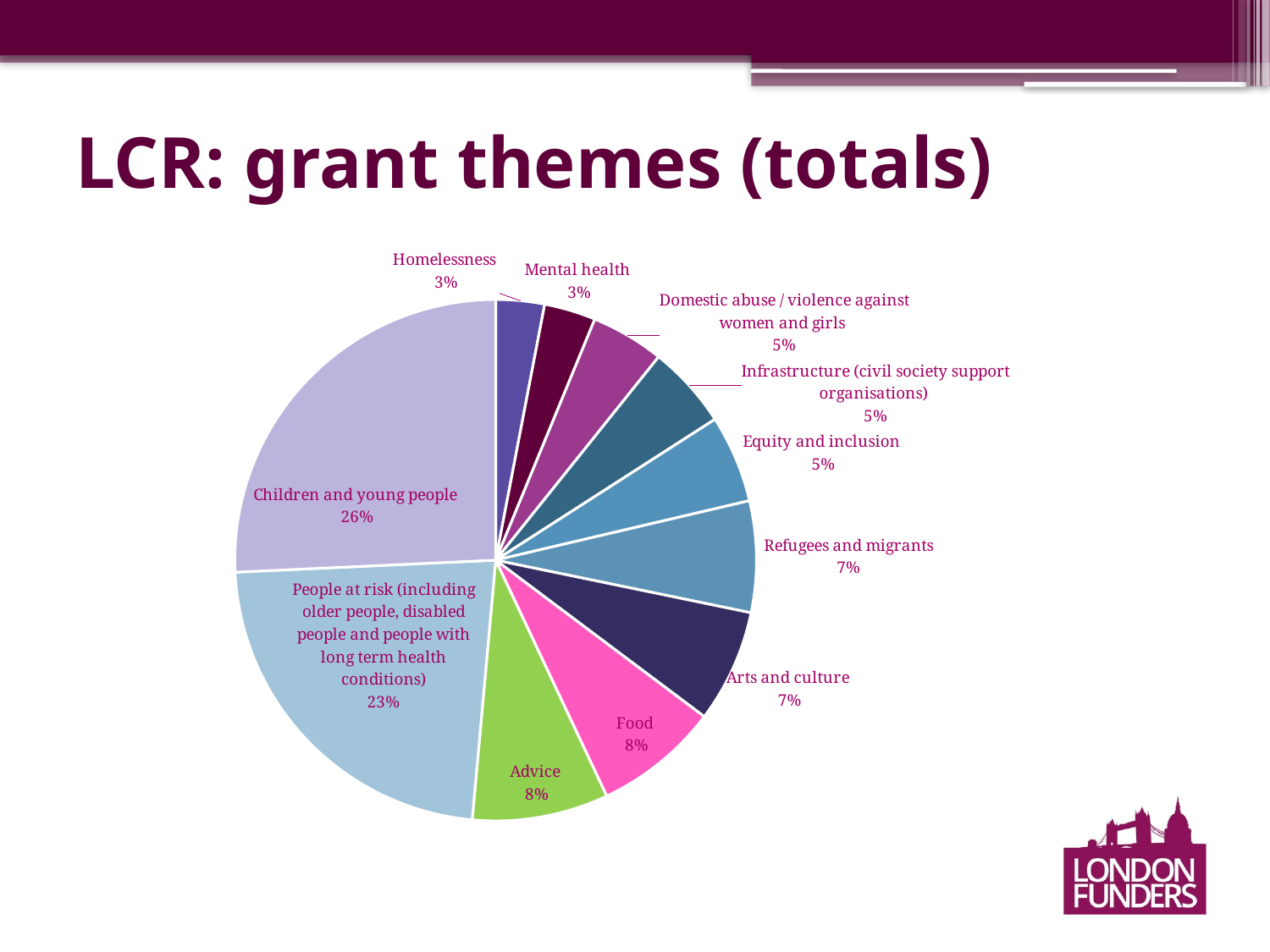
What percentage is shown for Domestic abuse / violence against women and girls? 5% What percentage is shown for Refugees and migrants? 7% Which grant theme has the largest share of the pie? Children and young people How many slices does the pie chart have? 11 What share of the pie is Children and young people? 26% Which is larger, the share for Advice or the share for Arts and culture? Advice What is the difference in percentage points between Children and young people and People at risk? 3 What kind of chart is shown on the slide? pie chart What is the title of the chart on the slide? LCR: grant themes (totals) What is the combined share of Homelessness and Mental health? 6% What percentage is shown for Equity and inclusion? 5% What percentage is shown for Food? 8%